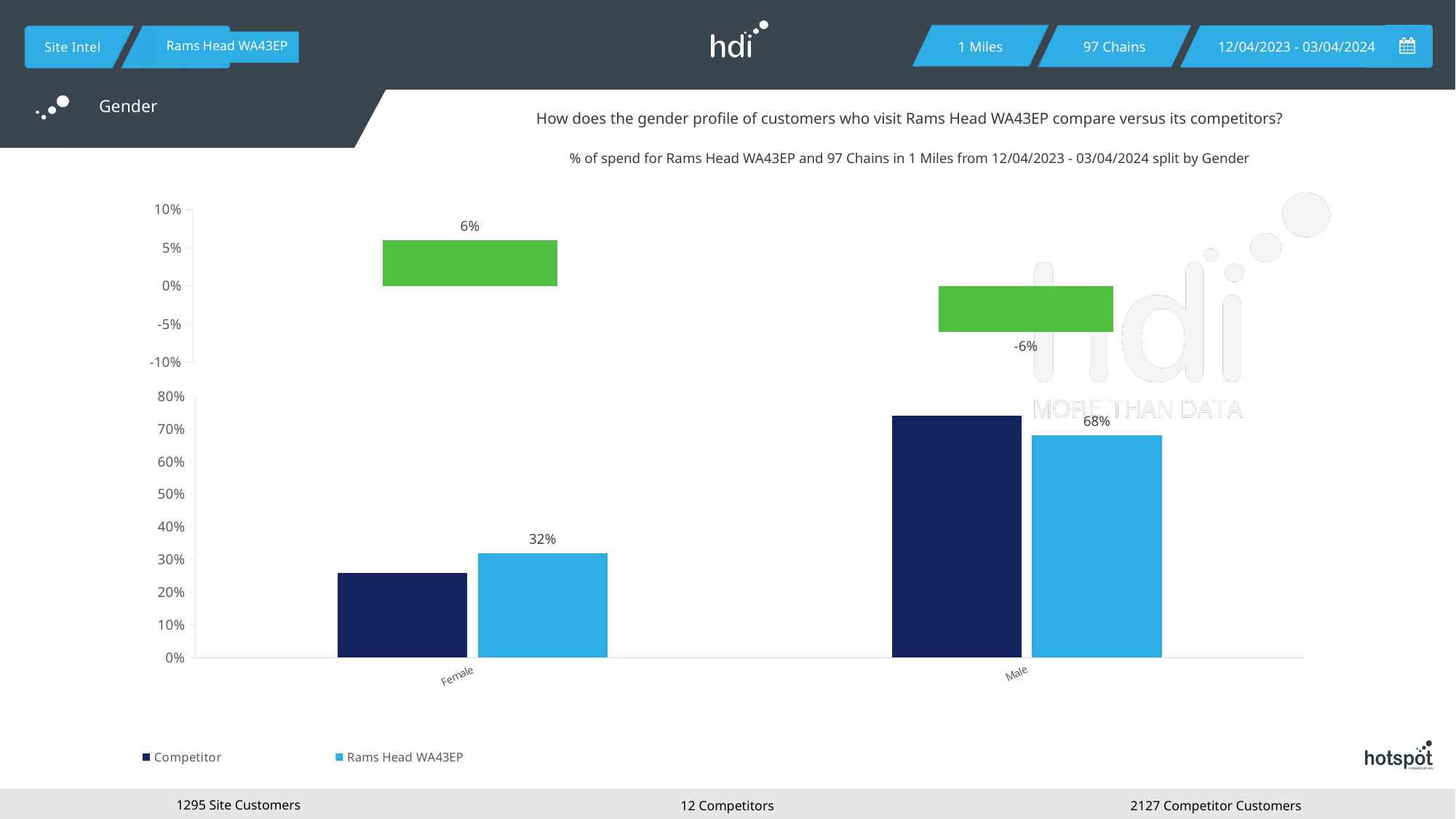
In the bottom chart, is the Competitor value for Female greater or less than 30%? less In the top chart, what is the value shown for the Male category? -6% In the bottom chart, what is the value for Rams Head WA43EP in the Female category? 32% In the bottom chart, is the Competitor value for Male greater or less than 70%? greater In the bottom chart, what is the difference between the Rams Head WA43EP values for Male and Female? 36% How many categories are shown on the x axis of the bottom chart? 2 How many series does the legend of the bottom chart list? 2 In the top chart, what is the value shown for the Female category? 6% In the bottom chart, what is the value for Rams Head WA43EP in the Male category? 68% What kind of chart is the bottom chart? bar chart In the bottom chart, for the Female category, which series has the larger value, Competitor or Rams Head WA43EP? Rams Head WA43EP In the bottom chart, which category has the higher value for Rams Head WA43EP, Female or Male? Male